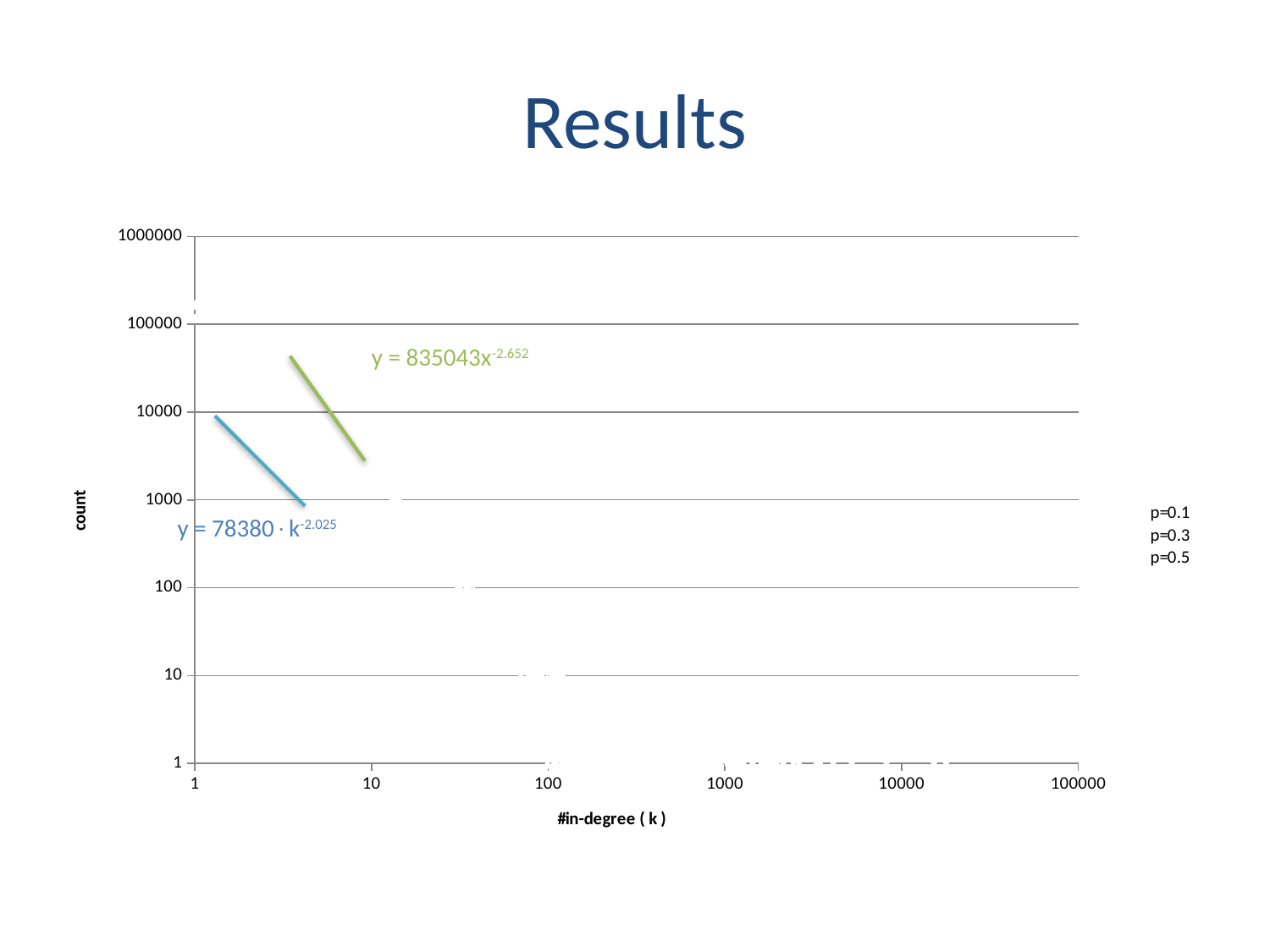
What is the title of the slide containing the chart? Results What is the label of the y axis? count What is the exponent in the blue trend line equation? -2.025 What is the label of the x axis? #in-degree ( k ) Do the trend lines rise or fall as in-degree k increases along the x axis? fall How many series does the legend list? 3 What is the exponent in the green trend line equation? -2.652 What equation is printed for the green trend line? y = 835043x^-2.652 What equation is printed for the blue trend line? y = 78380 · k^-2.025